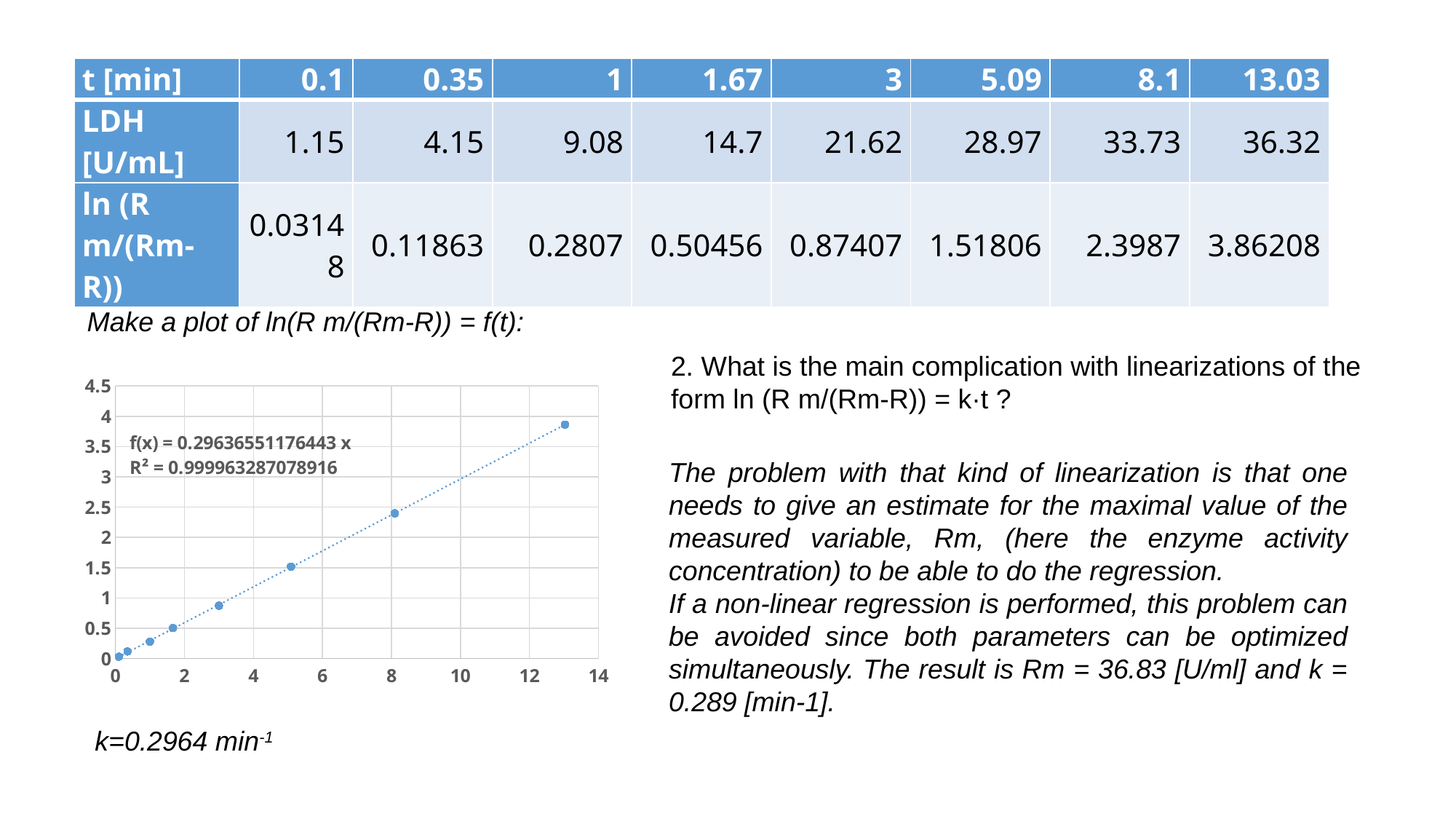
Is the value of the point at t ≈ 3 greater or less than 1? less Do the plotted values rise or fall as t increases along the x axis? rise Is the value of the point at t ≈ 8 greater or less than 2? greater What is the highest tick label shown on the y axis of the chart? 4.5 Which plotted point has the highest y value: the one at t ≈ 13 or the one at t ≈ 8? the one at t ≈ 13 Is the value of the point at t ≈ 5 greater or less than 1? greater What is the highest tick label shown on the x axis of the chart? 14 What R² value is printed on the chart? R² = 0.999963287078916 What is the trendline equation printed on the chart? f(x) = 0.29636551176443 x How many data points are plotted in the chart? 8 What kind of chart is shown on the slide? scatter chart